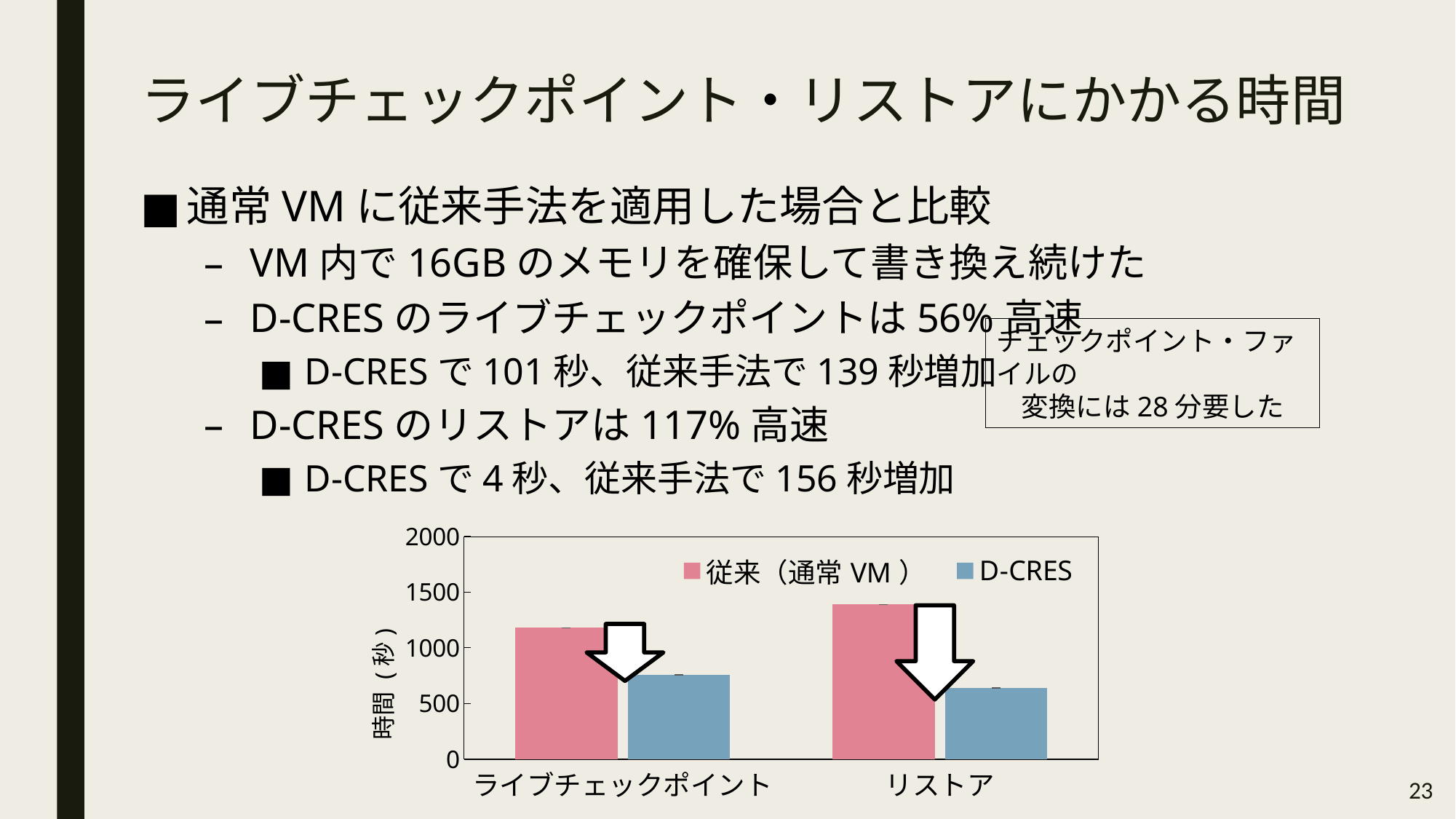
Is the D-CRES value for ライブチェックポイント greater or less than 1000? less What kind of chart is shown on the slide? bar chart What is the label of the y axis of the chart? 時間（秒） Is the 従来（通常 VM） value for リストア greater or less than 1500? less Is the 従来（通常 VM） value for ライブチェックポイント greater or less than 1000? greater How many series does the chart legend list? 2 Does the D-CRES series rise or fall from ライブチェックポイント to リストア? fall For リストア, which series has the larger value, 従来（通常 VM） or D-CRES? 従来（通常 VM） Which bar in the chart is the highest? 従来（通常 VM） for リストア How many categories are shown on the x axis of the chart? 2 What are the two series named in the chart legend? 従来（通常 VM）, D-CRES